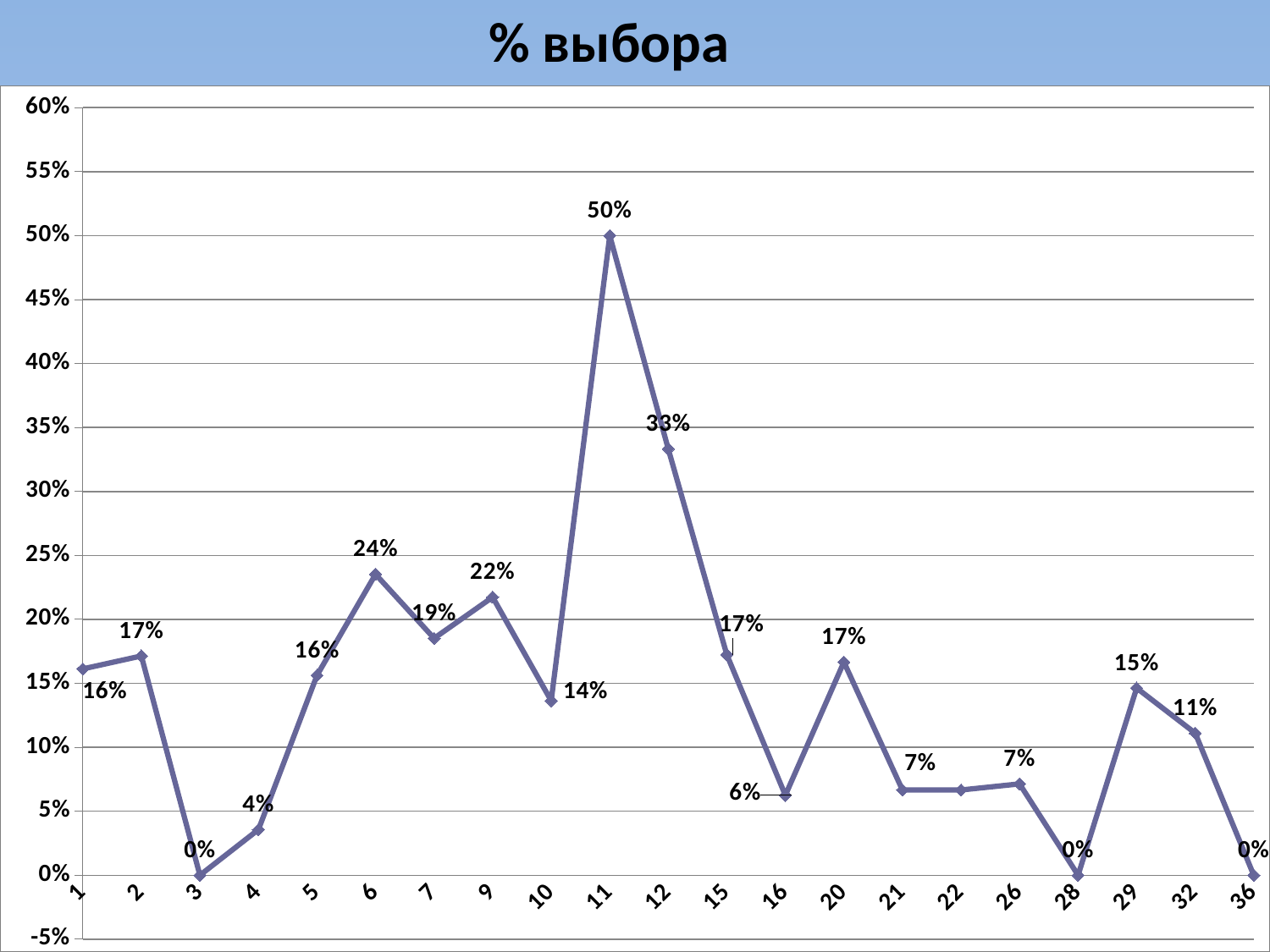
What is the difference between the values for categories 11 and 12? 17% Which category has the highest value? 11 What kind of chart is shown on the slide? line chart What is the title of the chart? % выбора Do the values rise or fall from category 28 to category 29? rise How many data points are plotted on the chart? 21 Which is larger, the value for category 9 or the value for category 10? 9 What is the value for category 32? 11% Is the value for category 12 greater or less than 30%? greater What is the value for category 11? 50% What is the value for category 6? 24% What is the value for category 16? 6%